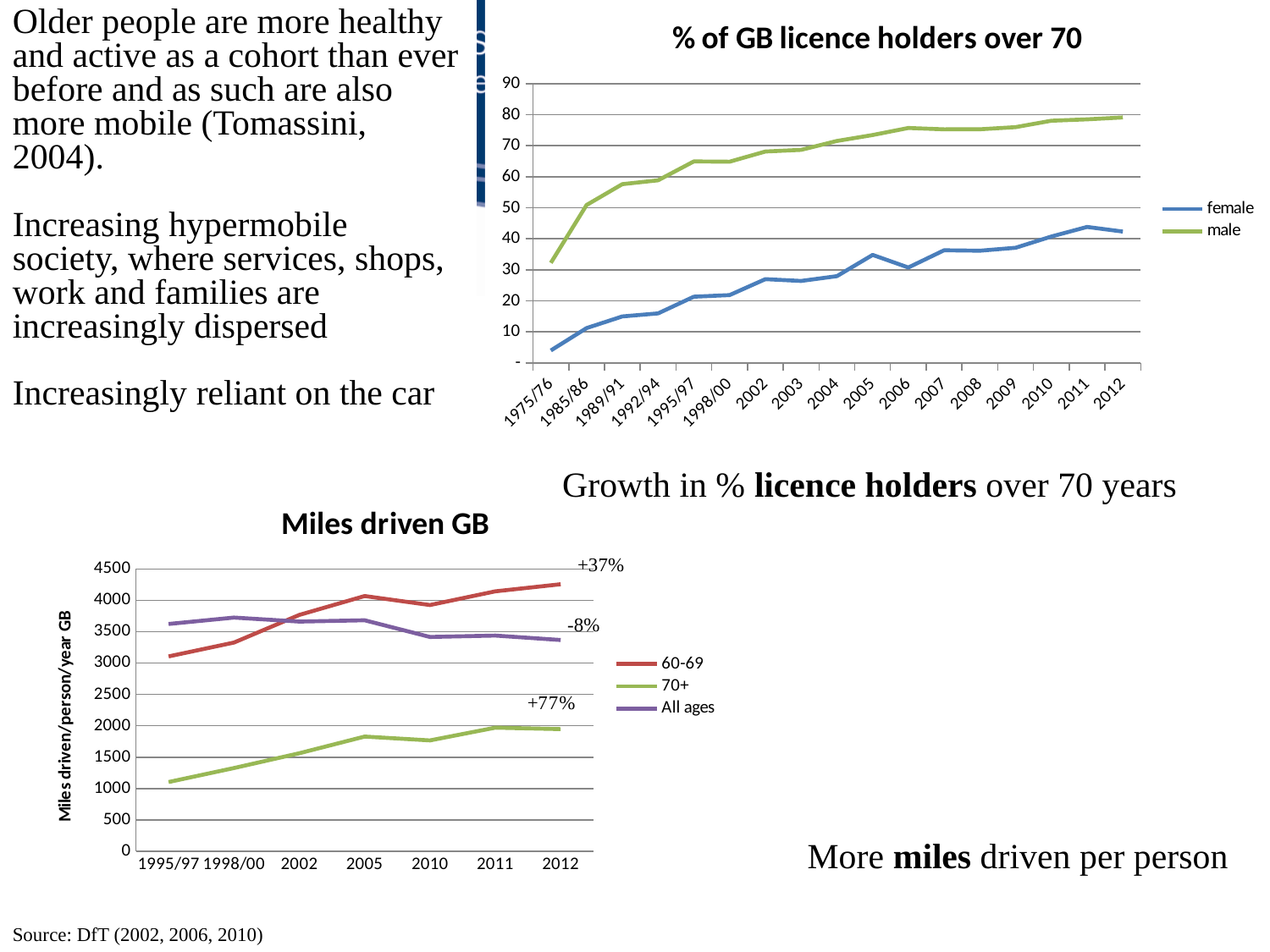
In the '% of GB licence holders over 70' chart, is the female value for 1975/76 greater or less than 10? less In the 'Miles driven GB' chart, which series is higher in 2012, 60-69 or All ages? 60-69 In the '% of GB licence holders over 70' chart, which series is higher in 2012, male or female? male In the '% of GB licence holders over 70' chart, does the male series rise or fall from 1975/76 to 2012? rise What type of chart is the '% of GB licence holders over 70' chart? line chart In the 'Miles driven GB' chart, what percentage change is annotated next to the 70+ series? +77% In the 'Miles driven GB' chart, is the 60-69 value for 2012 greater or less than 4000? greater How many series does the legend of the '% of GB licence holders over 70' chart list? 2 In the 'Miles driven GB' chart, is the 'All ages' value for 2012 greater or less than 3500? less How many series does the legend of the 'Miles driven GB' chart list? 3 How many points are on the x axis of the 'Miles driven GB' chart? 7